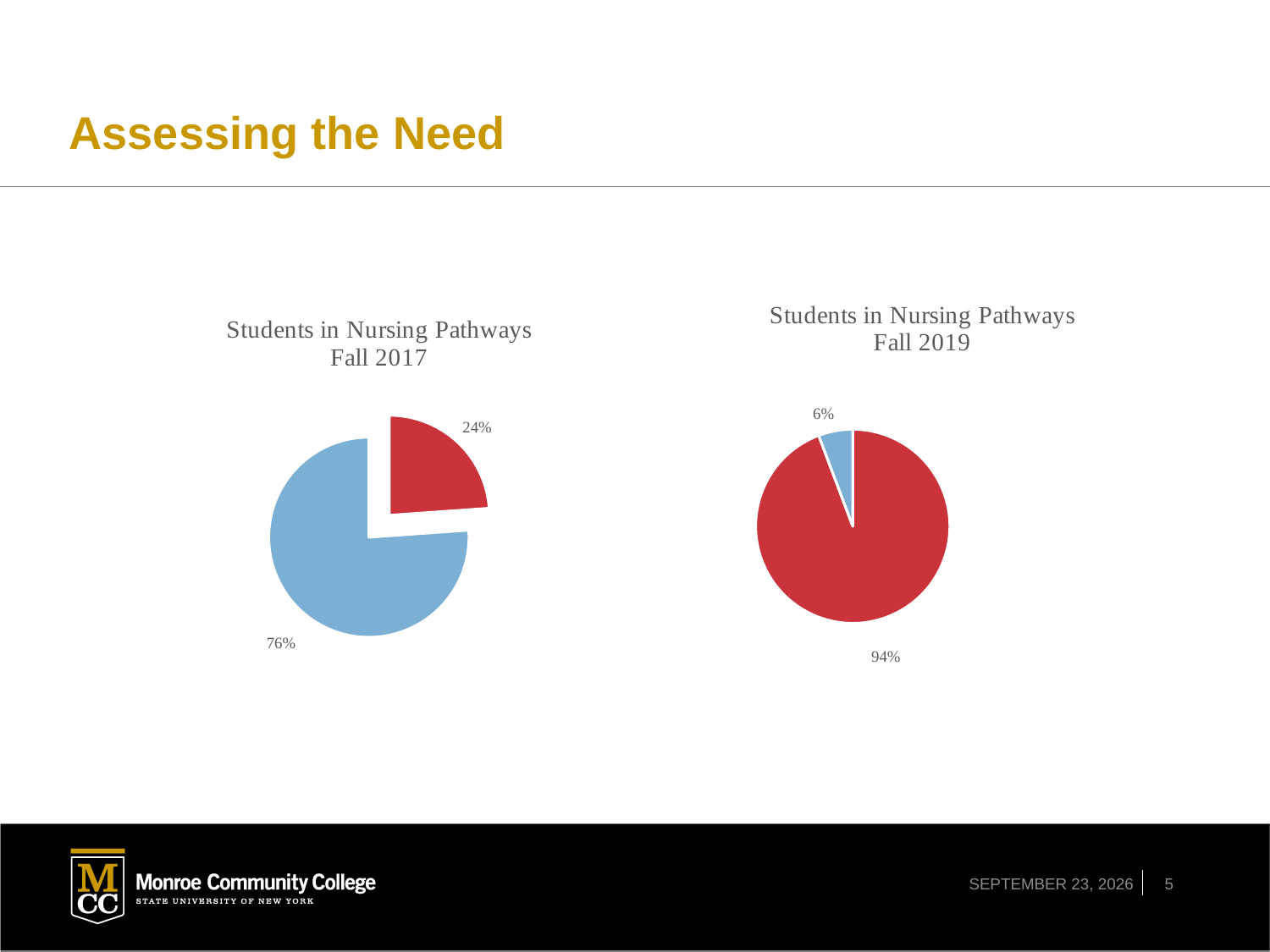
In the "Students in Nursing Pathways Fall 2019" chart, what percentage does the blue slice represent? 6% How many slices does the "Students in Nursing Pathways Fall 2019" pie chart have? 2 In the "Students in Nursing Pathways Fall 2017" chart, what percentage does the blue slice represent? 76% In the "Students in Nursing Pathways Fall 2017" chart, which slice is pulled out (exploded) from the pie? The red slice (24%) In the "Students in Nursing Pathways Fall 2017" chart, which slice is the largest? The blue slice (76%) Is the red slice larger in the "Students in Nursing Pathways Fall 2017" chart or in the "Students in Nursing Pathways Fall 2019" chart? Fall 2019 In the "Students in Nursing Pathways Fall 2019" chart, what percentage does the red slice represent? 94% In the "Students in Nursing Pathways Fall 2019" chart, which slice is the smallest? The blue slice (6%) In the "Students in Nursing Pathways Fall 2017" chart, what percentage does the red slice represent? 24% In the "Students in Nursing Pathways Fall 2017" chart, what is the difference in percentage points between the blue slice and the red slice? 52 percentage points What kind of chart is the "Students in Nursing Pathways Fall 2017" chart? Pie chart In the "Students in Nursing Pathways Fall 2019" chart, what is the difference in percentage points between the red slice and the blue slice? 88 percentage points